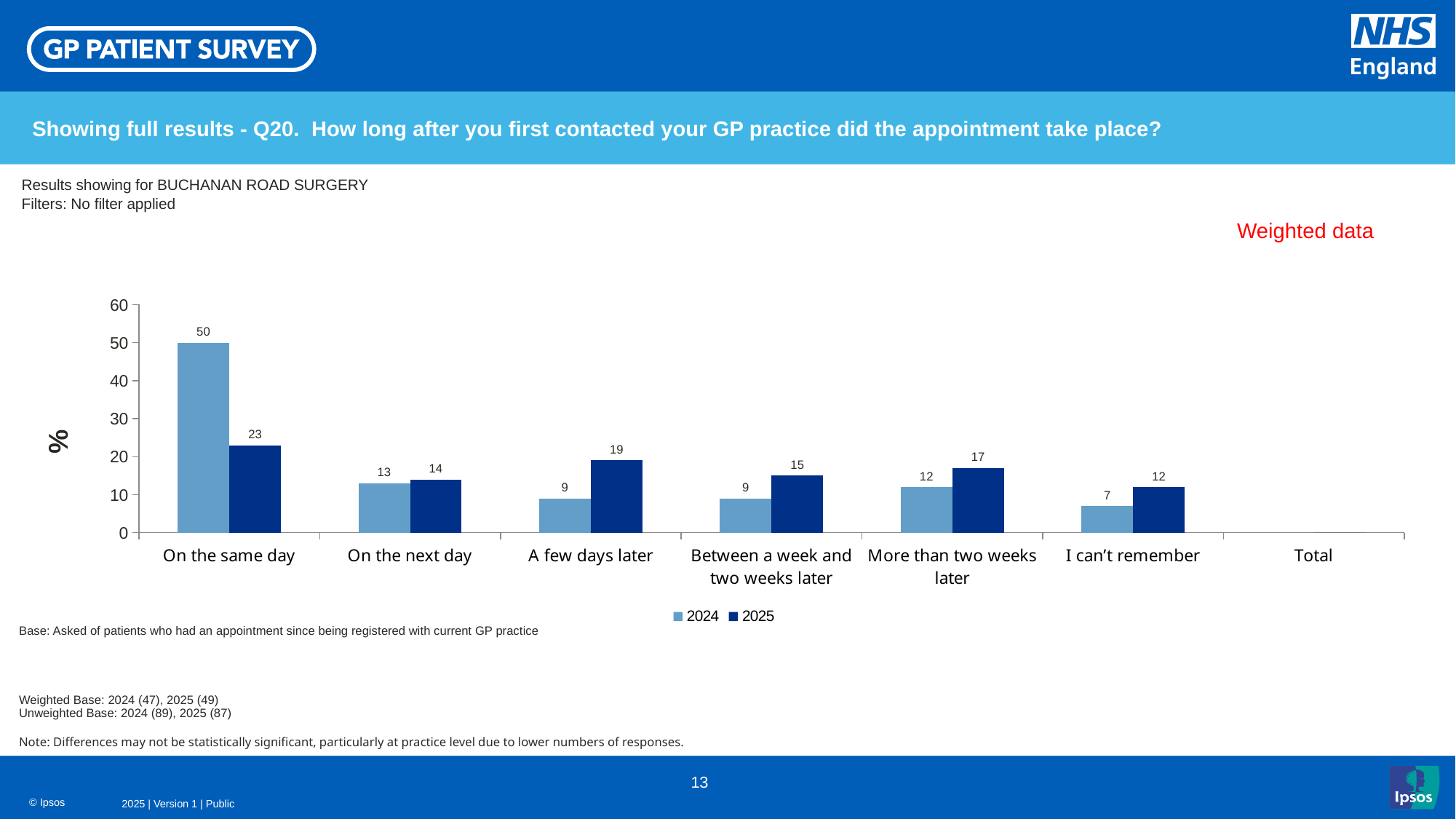
Which is larger for 'Between a week and two weeks later': the 2024 value or the 2025 value? 2025 What is the 2025 value for 'A few days later'? 19 Which category has the highest 2024 value? On the same day What kind of chart is shown on the slide? Bar chart What is the difference between the 2024 and 2025 values for 'On the same day'? 27 How many series does the legend list? 2 Is the 2024 value for 'On the same day' greater or less than 40? greater What is the 2025 value for 'More than two weeks later'? 17 Which series is shown in dark blue in the legend? 2025 Which category has the lowest 2024 value? I can't remember What is the label on the vertical axis? % What is the 2024 value for 'On the same day'? 50